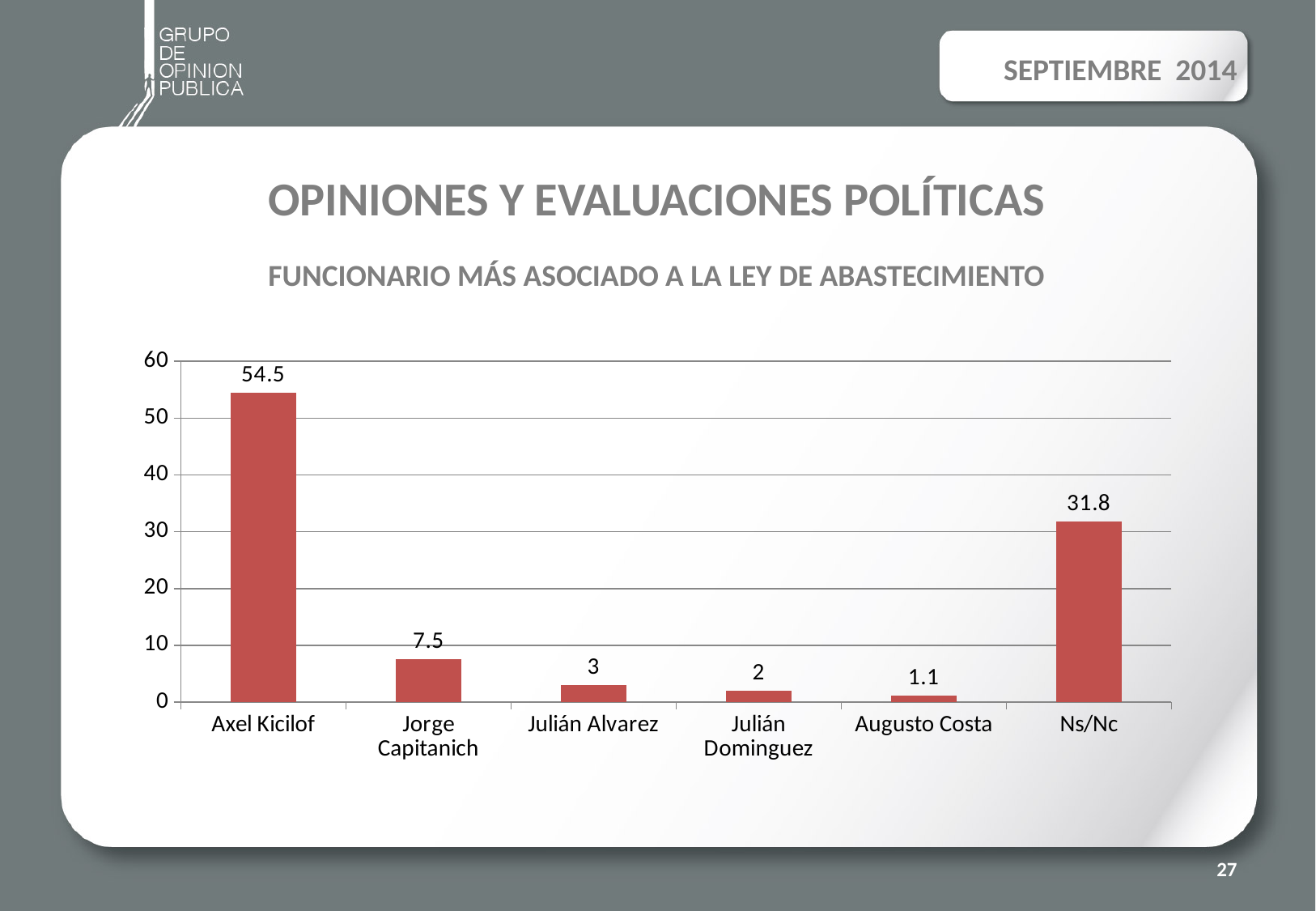
How many categories are shown on the x axis? 6 Which category has the lowest value? Augusto Costa What is the difference between the values for Axel Kicilof and Ns/Nc? 22.7 What is the value for Jorge Capitanich? 7.5 Which is larger, the value for Julián Alvarez or the value for Julián Dominguez? Julián Alvarez What is the value for Ns/Nc? 31.8 What is the subtitle of the chart on the slide? FUNCIONARIO MÁS ASOCIADO A LA LEY DE ABASTECIMIENTO What is the value for Axel Kicilof? 54.5 Which category has the highest value? Axel Kicilof Is the value for Ns/Nc greater or less than 30? greater What is the value for Augusto Costa? 1.1 What kind of chart is shown on the slide? bar chart